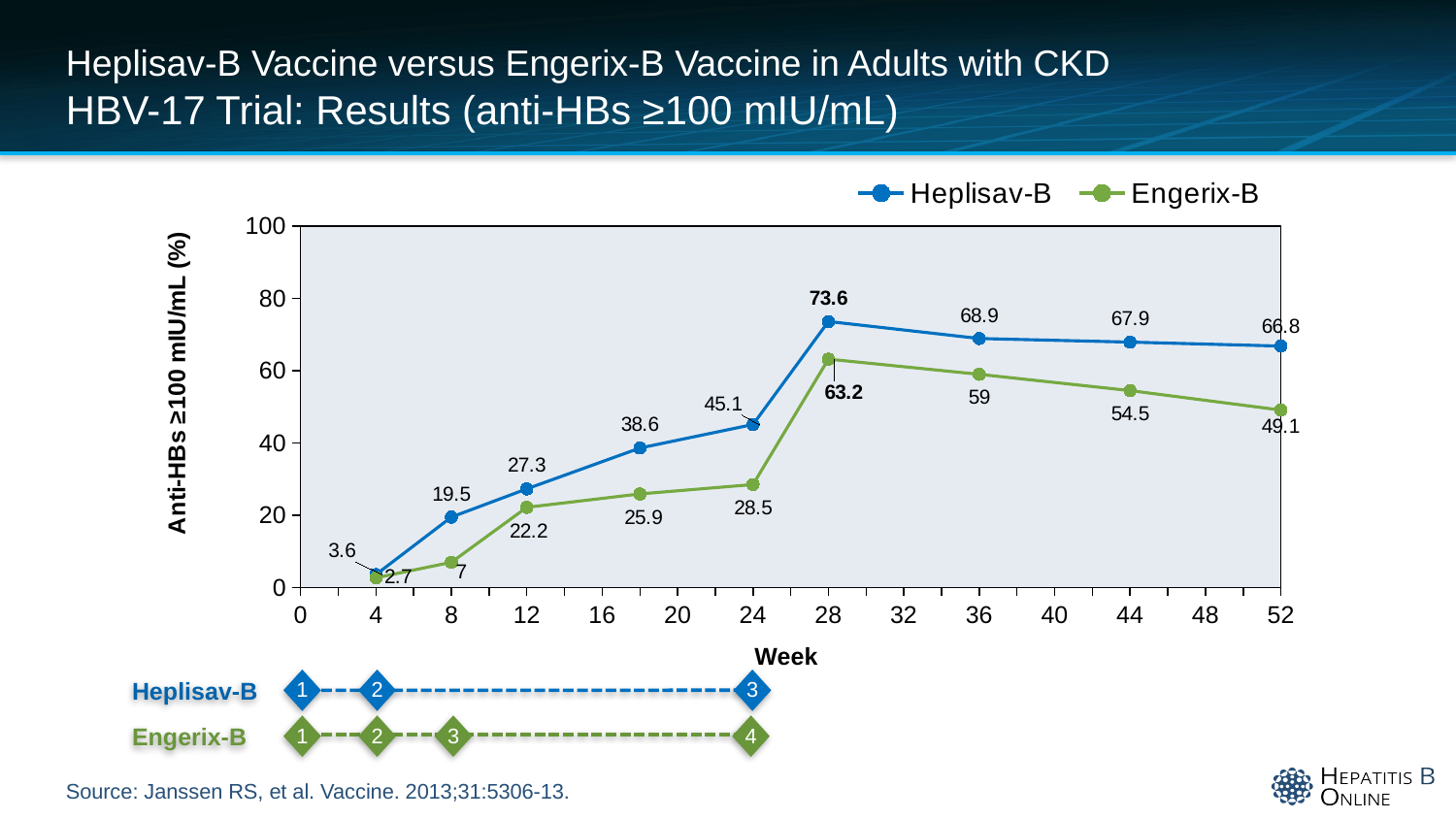
What is the Engerix-B value at week 8? 7 What is the difference between the Heplisav-B and Engerix-B values at week 28? 10.4 At week 12, which series has the higher value, Heplisav-B or Engerix-B? Heplisav-B Does the Engerix-B series rise or fall from week 28 to week 52? Fall At which week does the Heplisav-B series reach its highest value? Week 28 What is the Engerix-B value at week 52? 49.1 How many data points are plotted for each series? 9 What is the Heplisav-B value at week 28? 73.6 At which week is the Engerix-B value lowest? Week 4 How many series does the legend list? 2 What kind of chart is shown on the slide? Line chart What is the difference between the Heplisav-B and Engerix-B values at week 52? 17.7